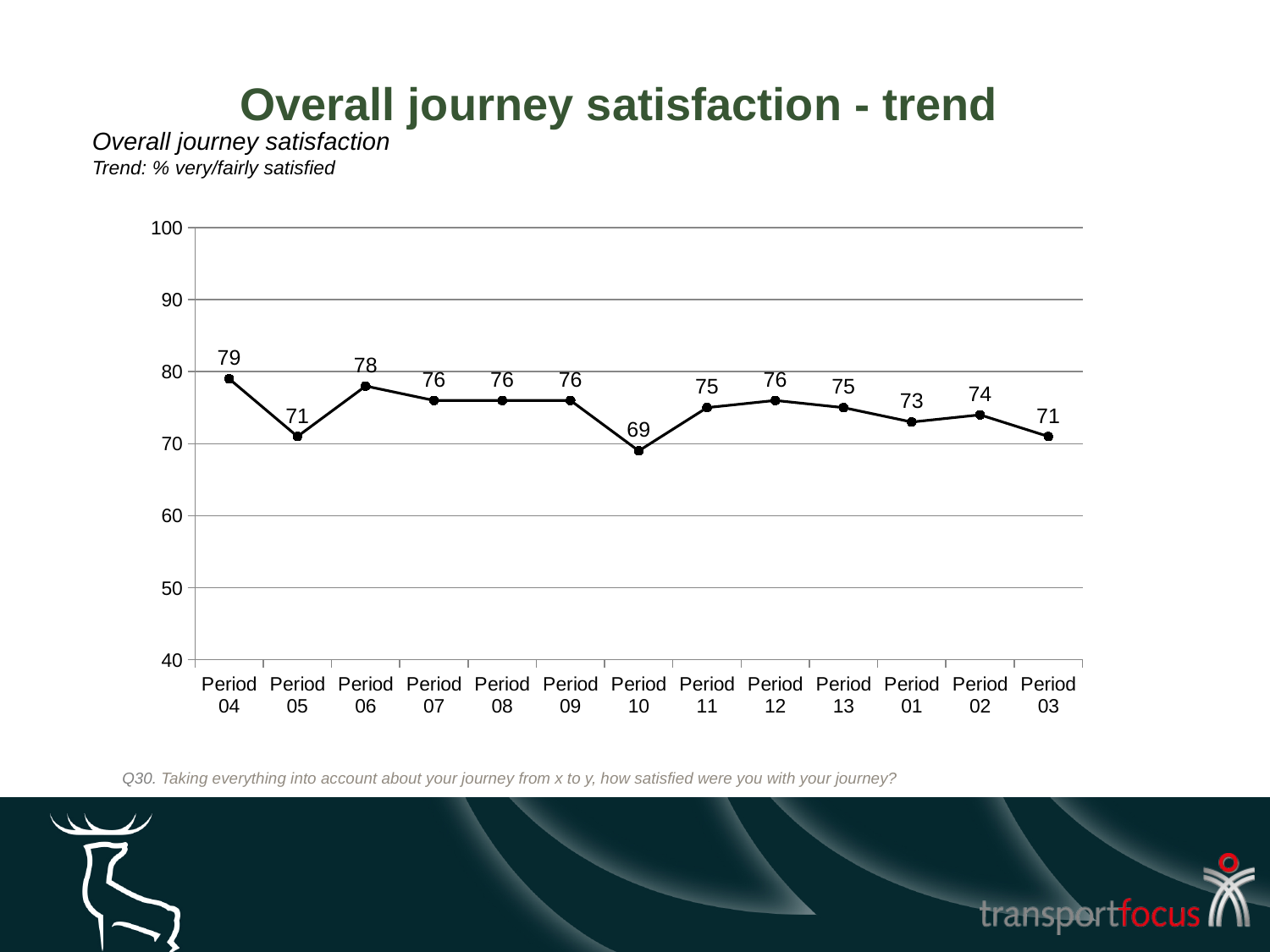
What is the difference between the values for Period 04 and Period 10? 10 Which period has the highest value? Period 04 Which period has the lowest value? Period 10 Is the value for Period 10 greater or less than 70? less What is the value for Period 04? 79 What is the value for Period 02? 74 Which is larger, the value for Period 12 or the value for Period 01? Period 12 What kind of chart is shown on the slide? line chart What is the difference between the values for Period 06 and Period 03? 7 How many periods are plotted on the chart? 13 Do the values rise or fall from Period 12 to Period 03? fall What is the value for Period 10? 69